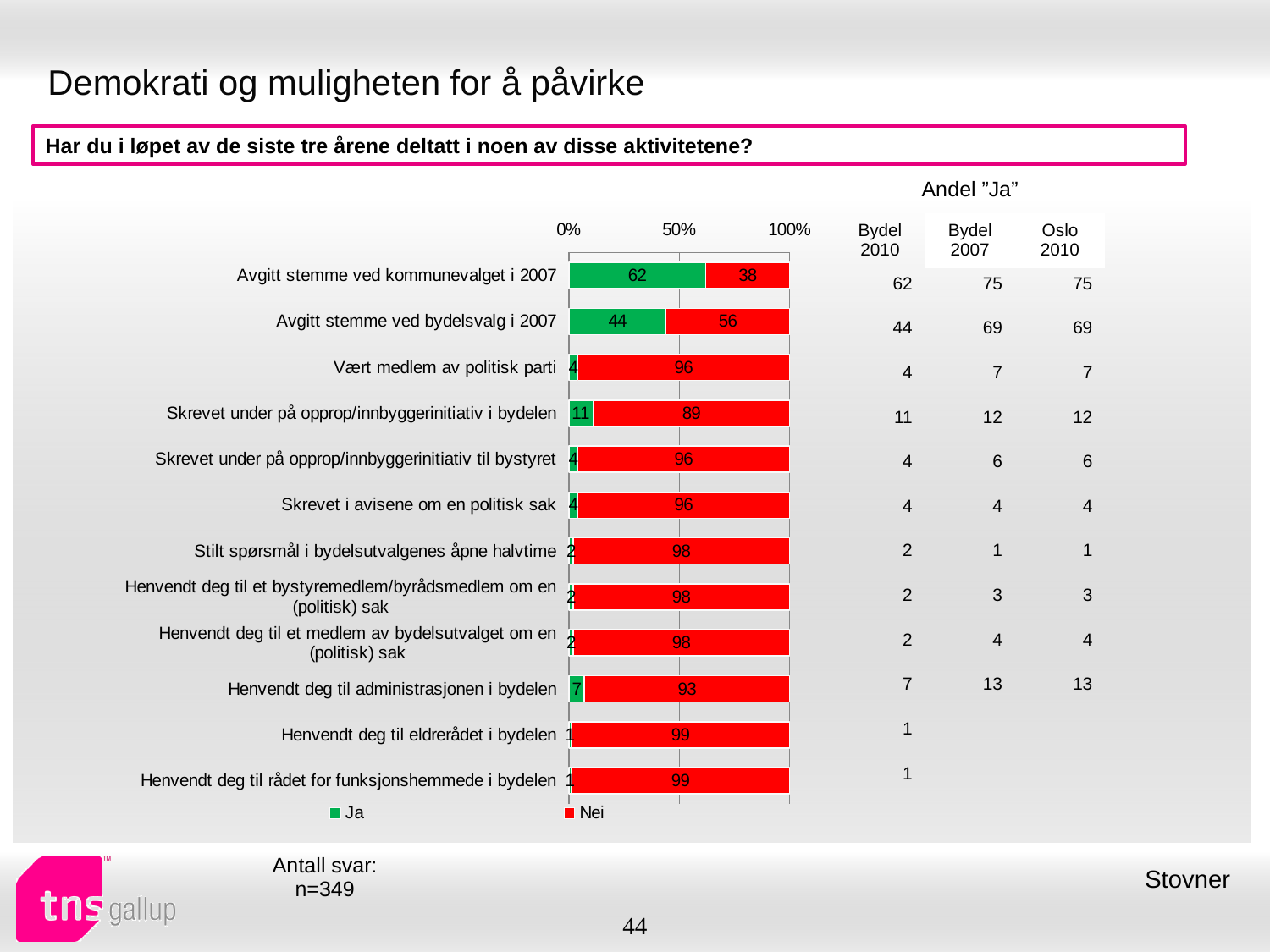
Which category has the lowest 'Nei' value? Avgitt stemme ved kommunevalget i 2007 What is the 'Nei' value for 'Avgitt stemme ved bydelsvalg i 2007'? 56 What is the total of the stacked bar for 'Avgitt stemme ved kommunevalget i 2007'? 100 What is the 'Ja' value for 'Avgitt stemme ved kommunevalget i 2007'? 62 What is the 'Ja' value for 'Skrevet under på opprop/innbyggerinitiativ i bydelen'? 11 What kind of chart is shown on the slide? Stacked bar chart What is the 'Nei' value for 'Henvendt deg til administrasjonen i bydelen'? 93 What is the difference between the 'Ja' values for 'Avgitt stemme ved kommunevalget i 2007' and 'Avgitt stemme ved bydelsvalg i 2007'? 18 Which category has the highest 'Ja' value? Avgitt stemme ved kommunevalget i 2007 How many series does the legend list? 2 Which has a larger 'Ja' value: 'Skrevet under på opprop/innbyggerinitiativ i bydelen' or 'Henvendt deg til administrasjonen i bydelen'? Skrevet under på opprop/innbyggerinitiativ i bydelen How many categories are shown in the chart? 12